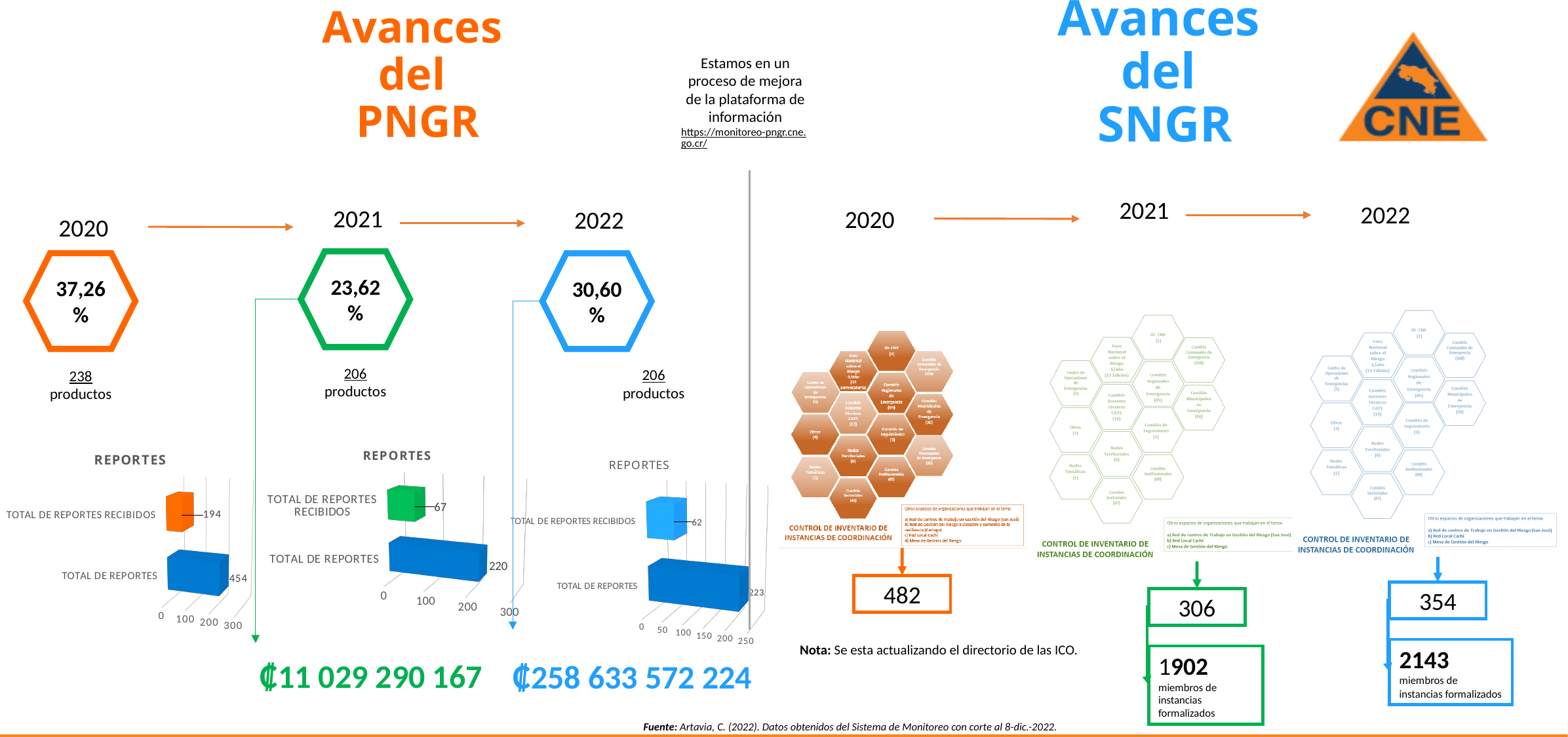
In the 2020 REPORTES chart, what is the difference between TOTAL DE REPORTES and TOTAL DE REPORTES RECIBIDOS? 260 What kind of chart is the 2021 REPORTES chart? Bar chart In the 2022 REPORTES chart (right of the PNGR section), what is the value for TOTAL DE REPORTES? 223 In the 2022 REPORTES chart, which category has the higher value, TOTAL DE REPORTES or TOTAL DE REPORTES RECIBIDOS? TOTAL DE REPORTES In the 2022 REPORTES chart (right of the PNGR section), what is the value for TOTAL DE REPORTES RECIBIDOS? 62 In the 2020 REPORTES chart (leftmost), what is the value for TOTAL DE REPORTES RECIBIDOS? 194 In the 2021 REPORTES chart (middle), what is the value for TOTAL DE REPORTES? 220 In the 2021 REPORTES chart (middle), what is the value for TOTAL DE REPORTES RECIBIDOS? 67 In the 2020 REPORTES chart (leftmost), what is the value for TOTAL DE REPORTES? 454 In the 2020 REPORTES chart, which category has the lowest value? TOTAL DE REPORTES RECIBIDOS How many categories are shown in the 2022 REPORTES chart? 2 In the 2021 REPORTES chart, what is the difference between TOTAL DE REPORTES and TOTAL DE REPORTES RECIBIDOS? 153